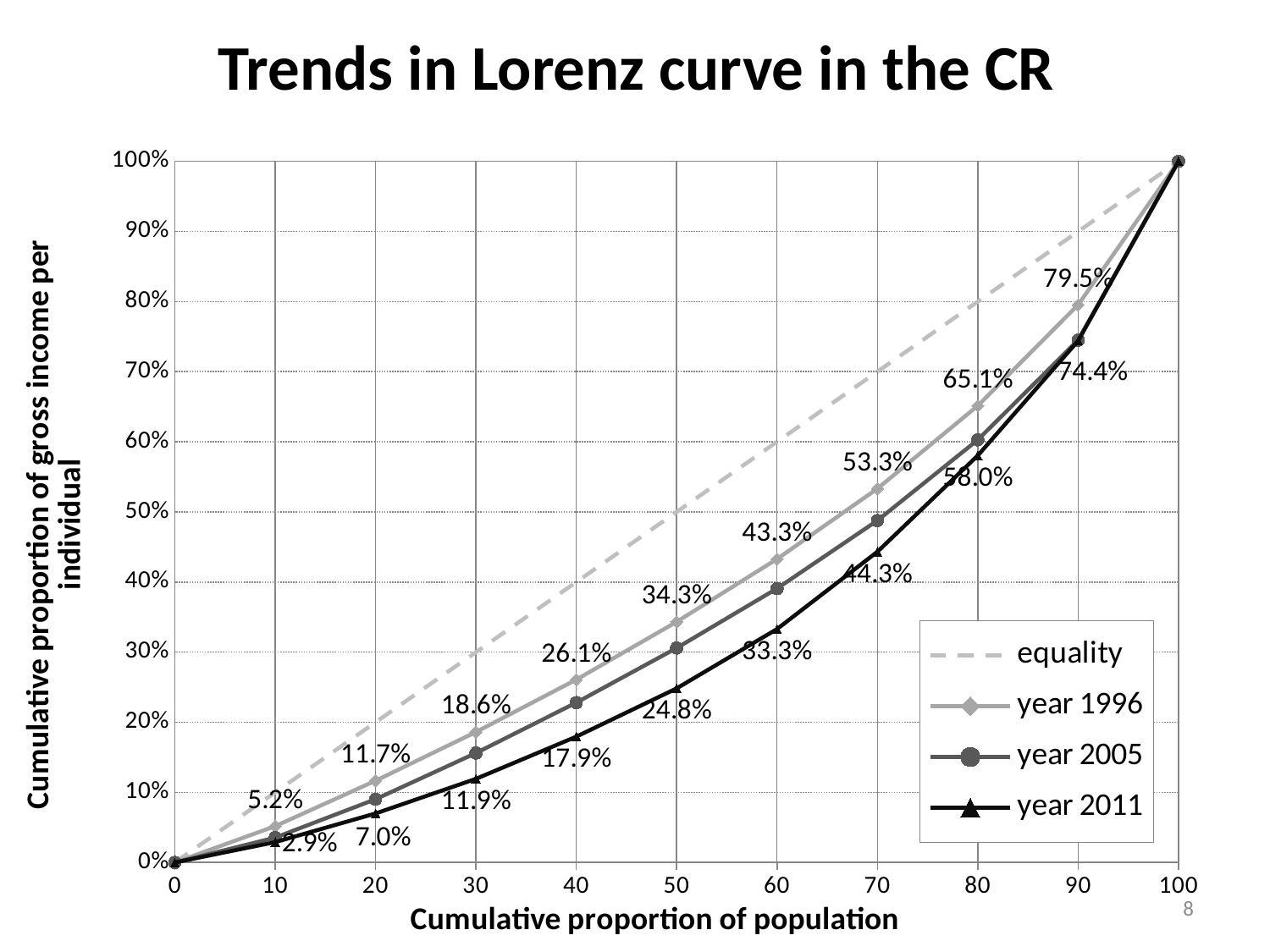
Which series is drawn as a dashed line? equality What is the value for year 1996 at a cumulative population proportion of 50? 34.3% What is the difference between the year 1996 and year 2011 values at a cumulative population proportion of 60? 10.0% Do the values for year 2011 rise or fall as the cumulative proportion of population increases? rise At a cumulative population proportion of 40, which is larger: the year 1996 value or the year 2011 value? year 1996 How many series does the legend list? 4 Is the value for year 2005 at a cumulative population proportion of 70 greater or less than 40%? greater What kind of chart is shown on the slide? line chart What is the value for year 2011 at a cumulative population proportion of 10? 2.9% What is the value for year 1996 at a cumulative population proportion of 90? 79.5% What is the title of the chart? Trends in Lorenz curve in the CR What is the value for year 2011 at a cumulative population proportion of 80? 58.0%